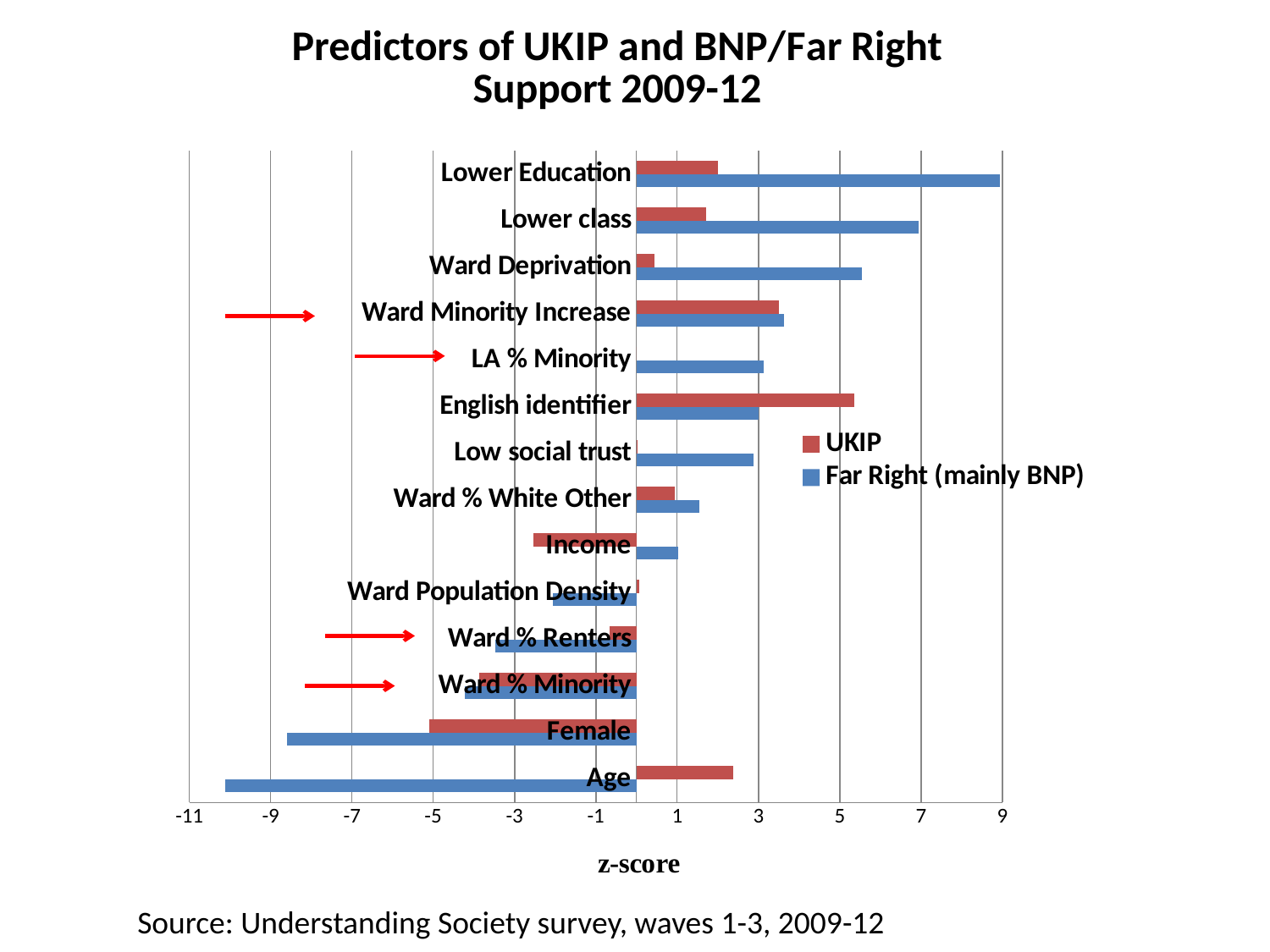
How many predictor categories are plotted on the chart? 14 Is the UKIP value for English identifier greater or less than 3? greater Which predictor has the lowest Far Right (mainly BNP) z-score? Age Is the Far Right (mainly BNP) value for Lower Education greater or less than 7? greater Which predictor has the highest UKIP z-score? English identifier How many series does the legend list? 2 Is the Far Right (mainly BNP) value for Age greater or less than -9? less For English identifier, which series has the larger z-score, UKIP or Far Right (mainly BNP)? UKIP What is the title of the horizontal axis? z-score Which predictor has the highest Far Right (mainly BNP) z-score? Lower Education Which predictor has the lowest UKIP z-score? Female What kind of chart is shown on the slide? bar chart